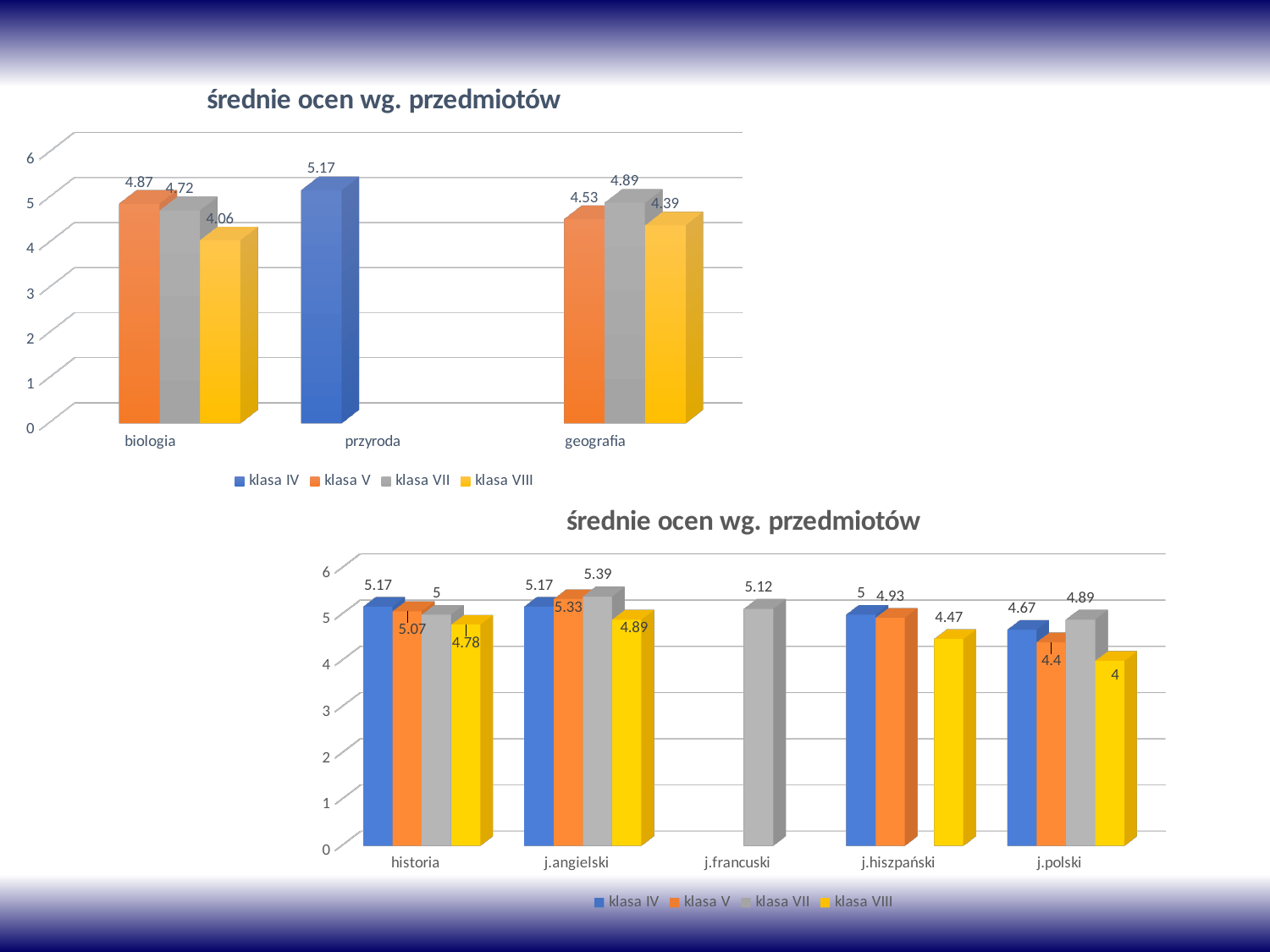
In the top chart, what is the value for klasa VIII in biologia? 4.06 In the top chart, what is the value for klasa IV in przyroda? 5.17 In the top chart, what is the difference between klasa V and klasa VIII in biologia? 0.81 In the bottom chart, which series has the lowest value in historia? klasa VIII In the top chart, how many categories are shown on the x axis? 3 In the bottom chart, what is the value for klasa VIII in j.polski? 4 What type of chart is the bottom chart? bar chart In the bottom chart, which is larger: klasa V in j.hiszpański or klasa V in j.polski? klasa V in j.hiszpański In the top chart, which series has the highest value in geografia? klasa VII In the bottom chart, how many series does the legend list? 4 In the bottom chart, what is the value for klasa VII in j.francuski? 5.12 In the bottom chart, which series has the highest value in j.angielski? klasa VII